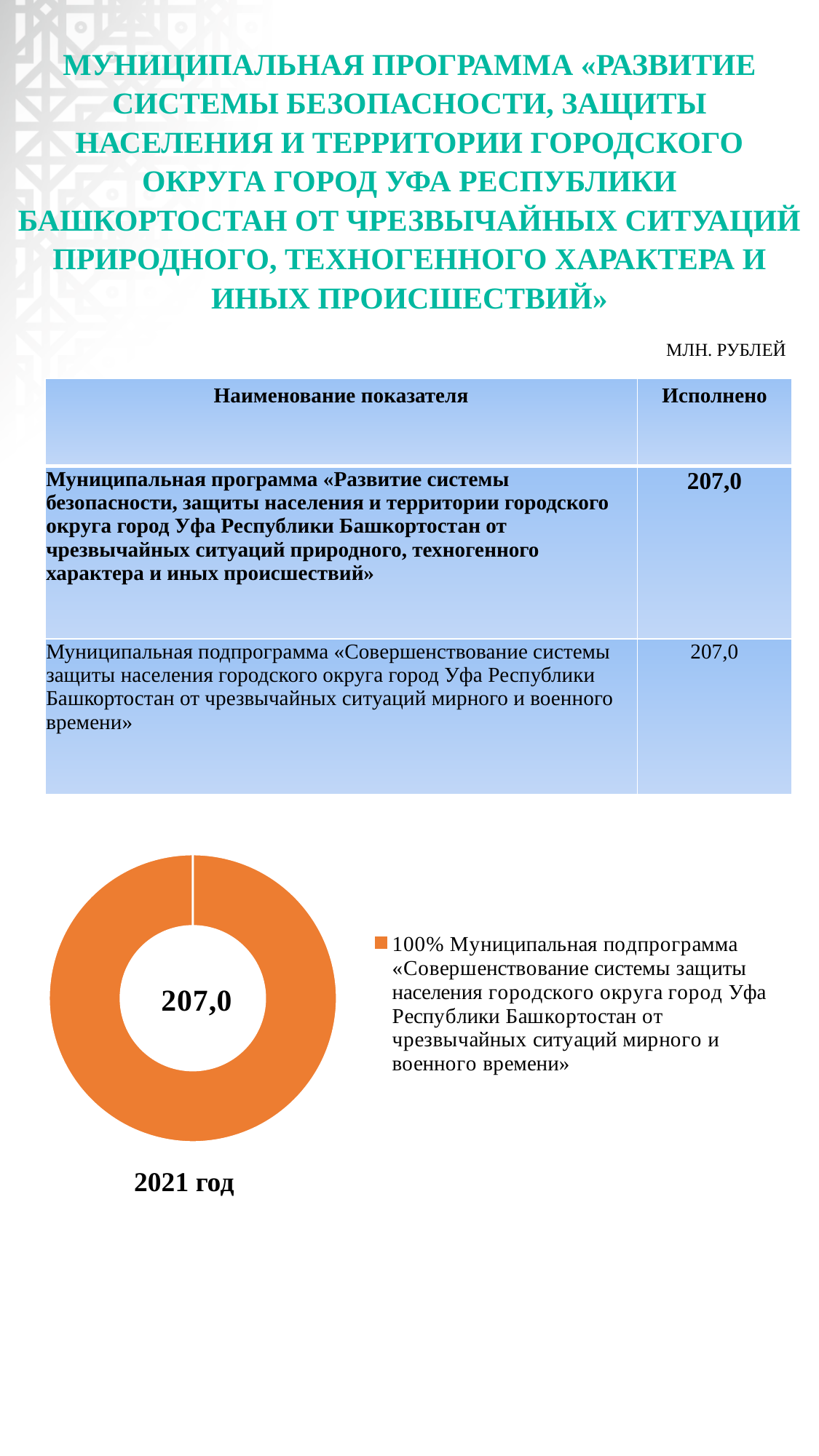
What colour is the single slice of the doughnut chart? orange How many entries does the legend of the doughnut chart list? 1 What year is labelled beneath the doughnut chart? 2021 год What share of the doughnut chart does the slice for the municipal subprogram «Совершенствование системы защиты населения городского округа город Уфа Республики Башкортостан от чрезвычайных ситуаций мирного и военного времени» represent? 100% What value is printed in the centre of the doughnut chart? 207,0 How many slices does the doughnut chart have? 1 In what units are the values on the slide expressed, according to the label above the table? млн. рублей What kind of chart is shown on the slide? doughnut chart